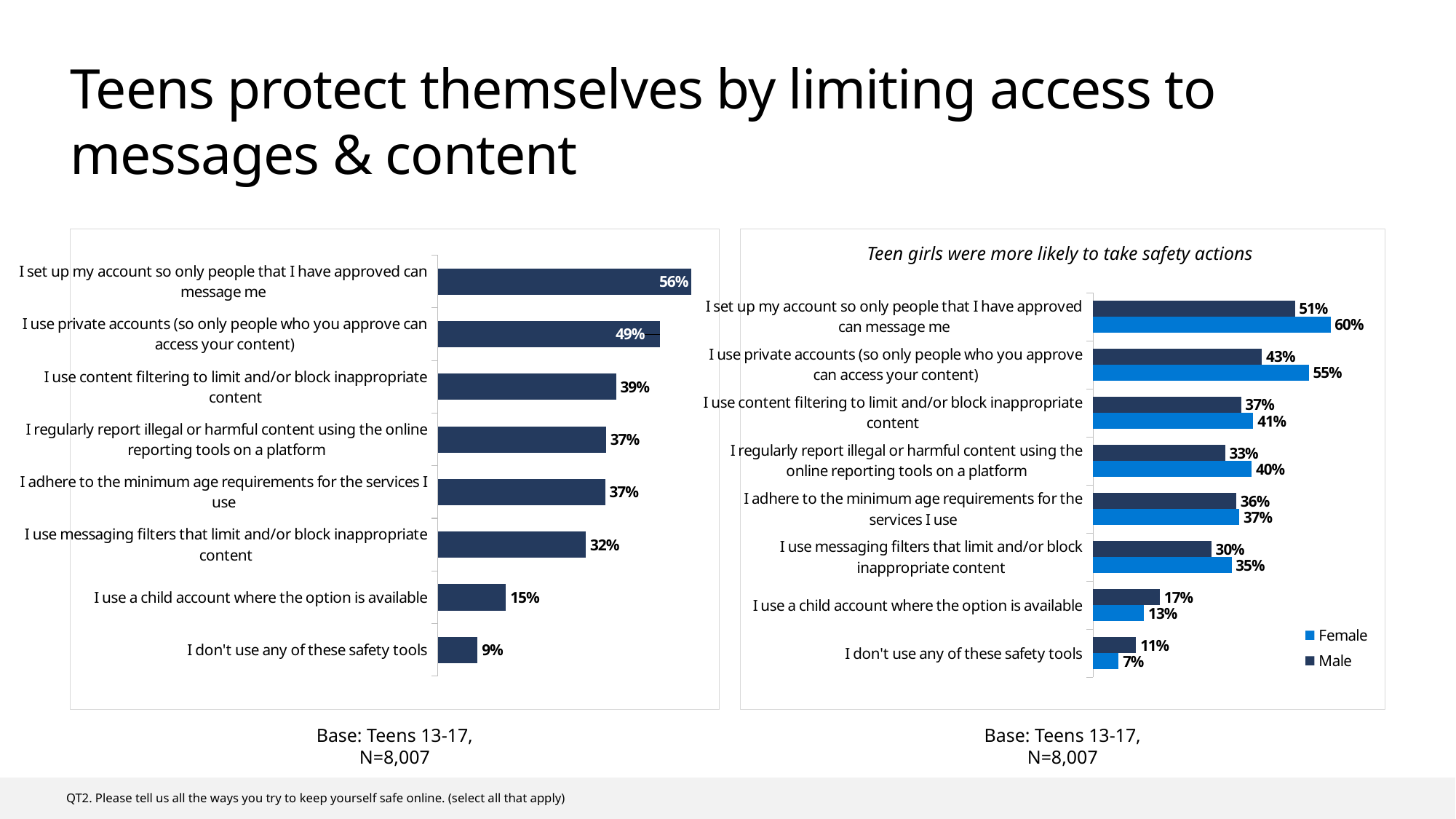
In the left chart, what percentage of teens set up their account so only approved people can message them? 56% What is the title of the right chart? Teen girls were more likely to take safety actions How many series does the legend of the right chart list? 2 In the right chart titled 'Teen girls were more likely to take safety actions', what is the Female value for using private accounts? 55% In the left chart, how many categories are shown? 8 In the right chart titled 'Teen girls were more likely to take safety actions', what is the Male value for regularly reporting illegal or harmful content? 33% In the right chart titled 'Teen girls were more likely to take safety actions', which category has the highest Female value? I set up my account so only people that I have approved can message me In the right chart titled 'Teen girls were more likely to take safety actions', which is larger for 'I use a child account where the option is available': Female or Male? Male In the right chart titled 'Teen girls were more likely to take safety actions', what is the difference between the Female and Male values for setting up an account so only approved people can message them? 9% What type of chart is the left chart? Bar chart In the left chart, what is the difference between the percentage who use private accounts and the percentage who use content filtering? 10% In the left chart, which safety action has the lowest percentage? I don't use any of these safety tools